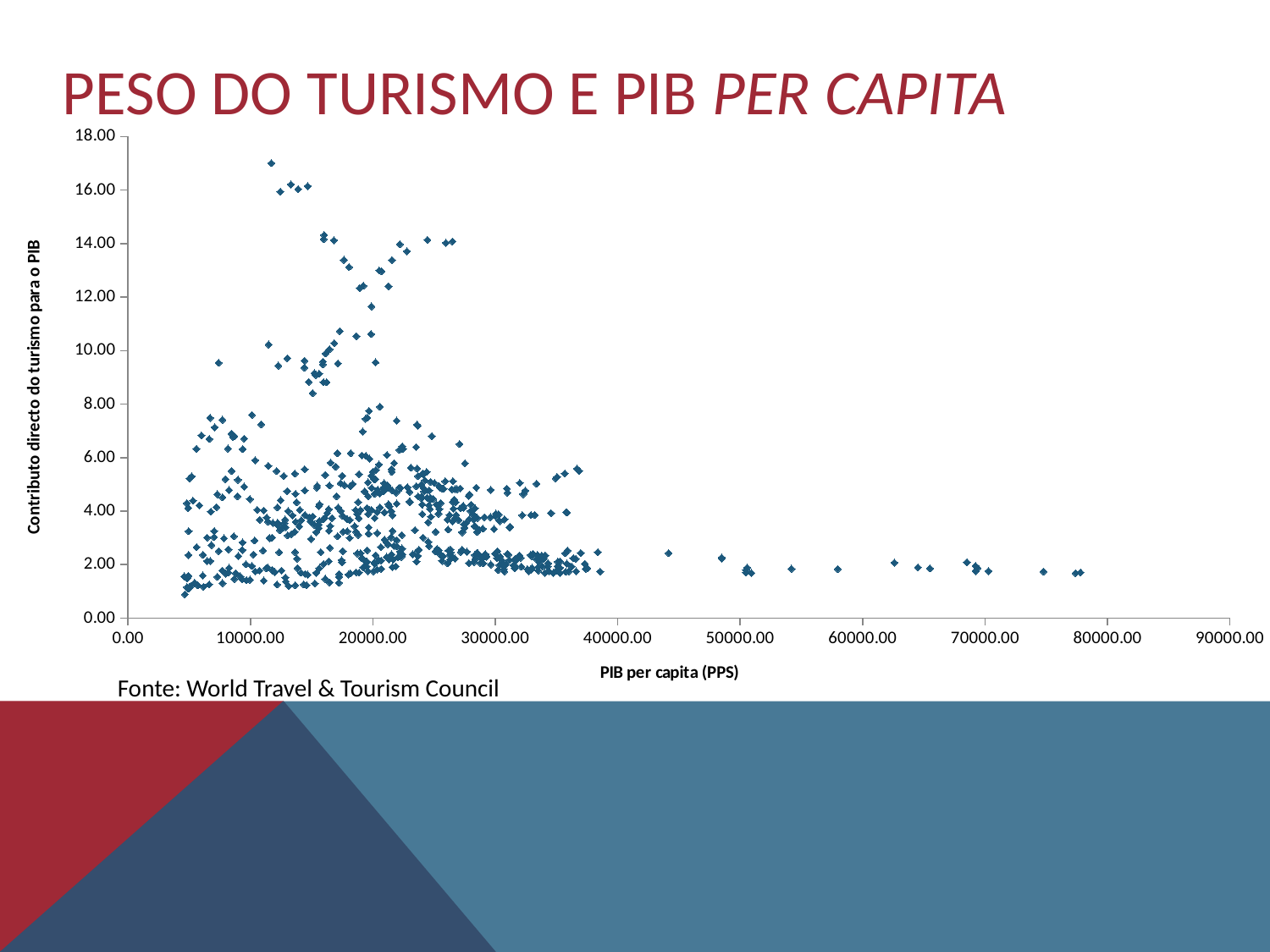
What is the highest tick value shown on the horizontal axis of the chart? 90000.00 What is the label of the horizontal axis of the chart? PIB per capita (PPS) As PIB per capita increases beyond 40000.00, do the plotted values rise or fall compared with the cluster at lower PIB per capita? fall How many data series are plotted on the chart? 1 Is the highest point on the chart greater or less than 18.00 on the vertical axis? less Is the highest point on the chart greater or less than 16.00 on the vertical axis? greater What is the highest tick value shown on the vertical axis of the chart? 18.00 Do the points with the highest tourism contribution occur at PIB per capita below or above 30000.00? below Is the rightmost point on the chart greater or less than 80000.00 on the horizontal axis? less What kind of chart is shown on the slide? Scatter plot What is the title of the chart on the slide? PESO DO TURISMO E PIB PER CAPITA